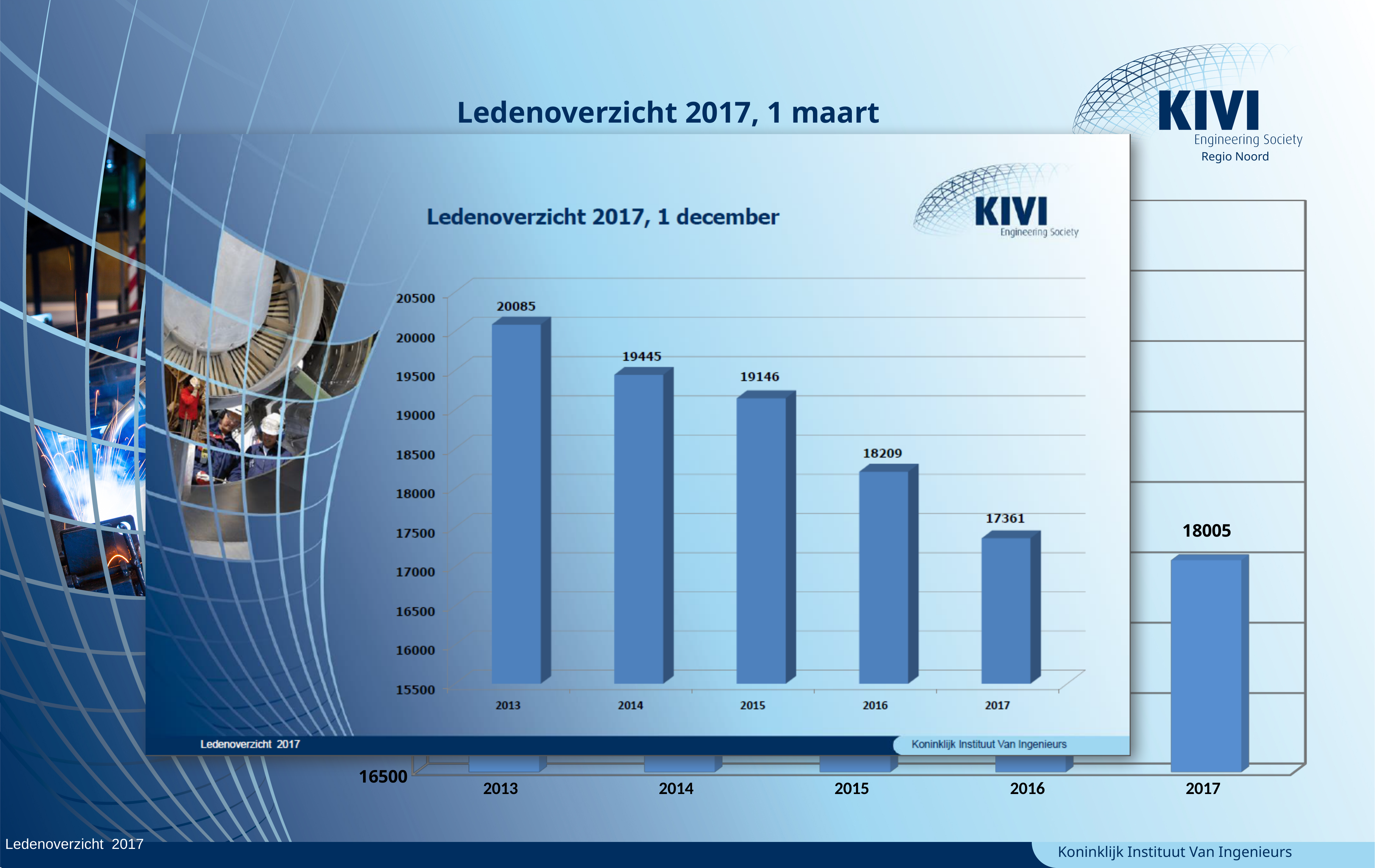
In the 'Ledenoverzicht 2017, 1 december' chart, what is the difference between the values for 2015 and 2016? 937 In the 'Ledenoverzicht 2017, 1 december' chart, do the values rise or fall from 2013 to 2017? Fall In the 'Ledenoverzicht 2017, 1 december' chart, which year has the lowest value? 2017 In the 'Ledenoverzicht 2017, 1 december' chart, which year has the highest value? 2013 In the 'Ledenoverzicht 2017, 1 december' chart, what is the value for 2017? 17361 In the 'Ledenoverzicht 2017, 1 december' chart, which is larger, the value for 2014 or the value for 2016? 2014 In the 'Ledenoverzicht 2017, 1 december' chart, what is the value for 2013? 20085 What kind of chart is the 'Ledenoverzicht 2017, 1 december' chart? Bar chart In the 'Ledenoverzicht 2017, 1 december' chart, what is the value for 2015? 19146 In the 'Ledenoverzicht 2017, 1 december' chart, how many years are shown on the x axis? 5 In the 'Ledenoverzicht 2017, 1 december' chart, what is the difference between the values for 2013 and 2017? 2724 In the 'Ledenoverzicht 2017, 1 maart' chart in the background, what is the value labelled for 2017? 18005